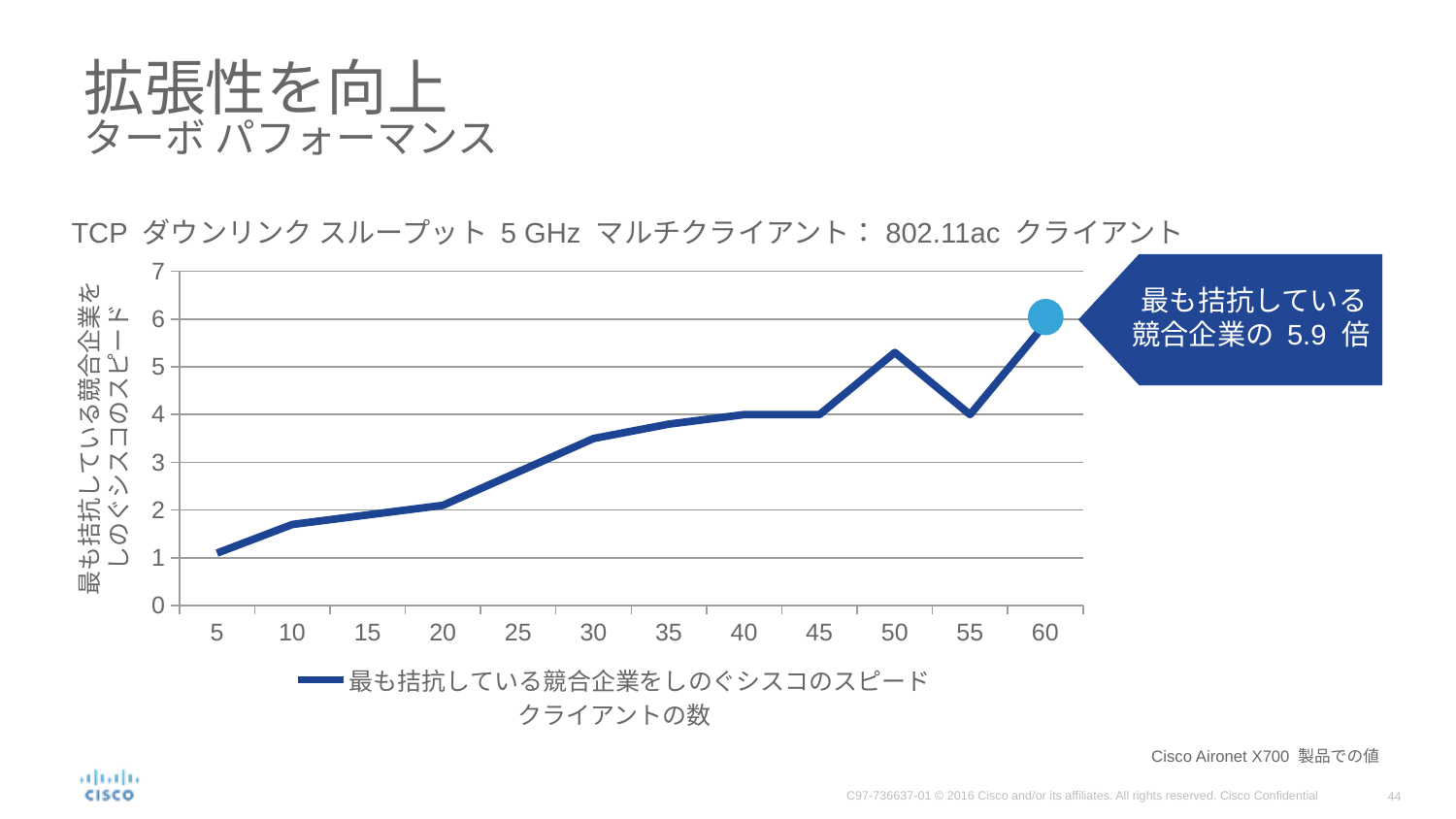
What is the label of the x axis? クライアントの数 How many series does the legend list? 1 Is the value at 5 clients greater or less than 2? less Which has the larger value: 50 clients or 55 clients? 50 clients At which number of clients is the plotted value highest? 60 Is the value at 50 clients greater or less than 5? greater At which number of clients is the plotted value lowest? 5 What kind of chart is shown on the slide? line chart How many data points are plotted along the x axis (client counts)? 12 Overall, do the values rise or fall as the number of clients increases from 5 to 60? rise According to the callout, how many times faster than the closest competitor is Cisco at 60 clients? 5.9 倍 Is the value at 30 clients greater or less than 3? greater